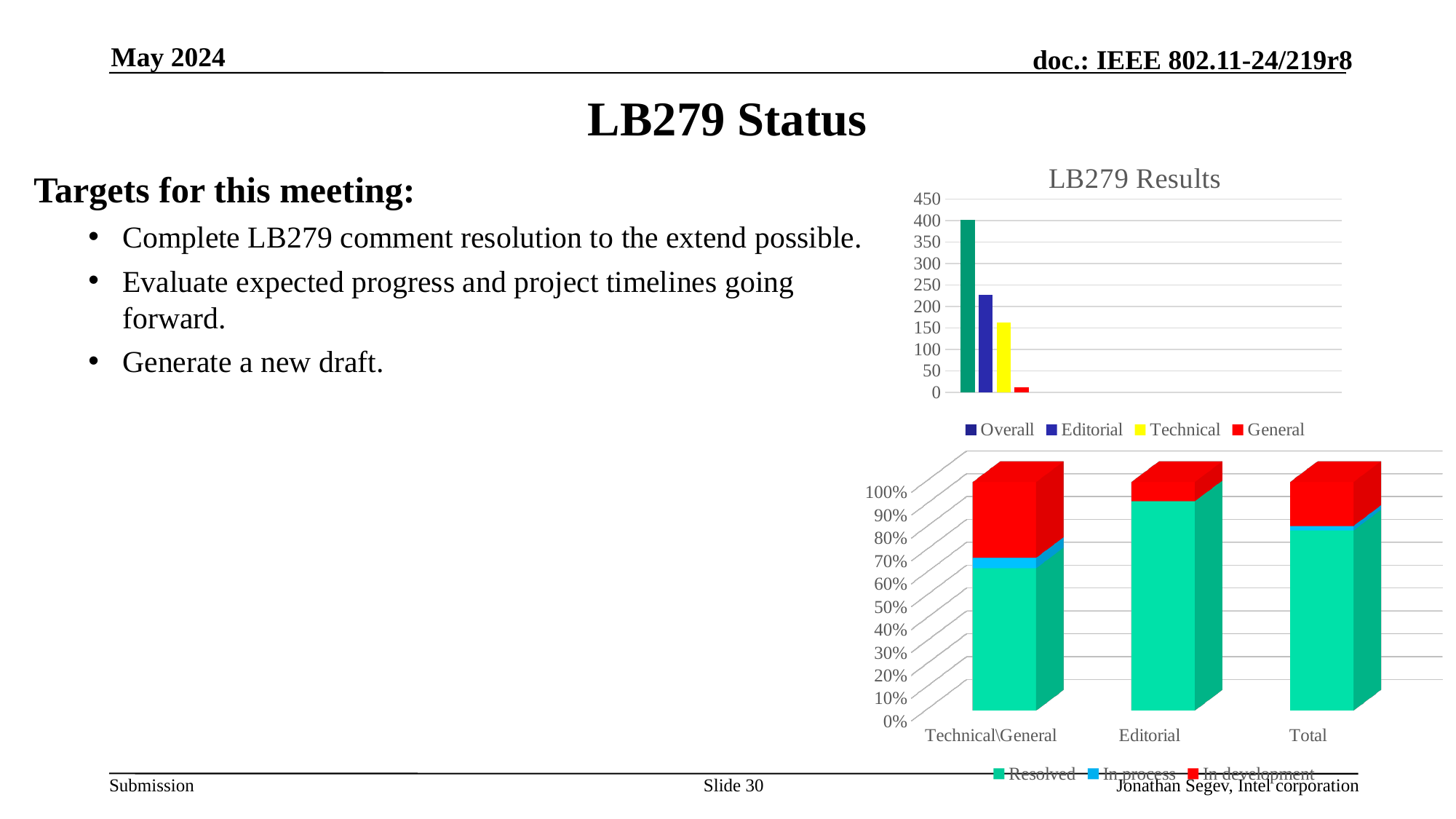
In the "LB279 Results" chart, which series has the lowest value? General In the "LB279 Results" chart, which is larger, Editorial or Technical? Editorial How many series does the legend of the "LB279 Results" chart list? 4 In the "LB279 Results" chart, which series has the highest value? Overall In the "LB279 Results" chart, is the value for Technical greater or less than 200? less How many series does the legend of the bottom stacked bar chart list? 3 In the bottom stacked bar chart, is the Resolved share for Technical\General greater or less than 80%? less What kind of chart is the "LB279 Results" chart? bar chart In the bottom stacked bar chart, which category has the largest Resolved share? Editorial In the "LB279 Results" chart, is the value for Editorial greater or less than 200? greater In the bottom stacked bar chart, how many categories are shown on the x axis? 3